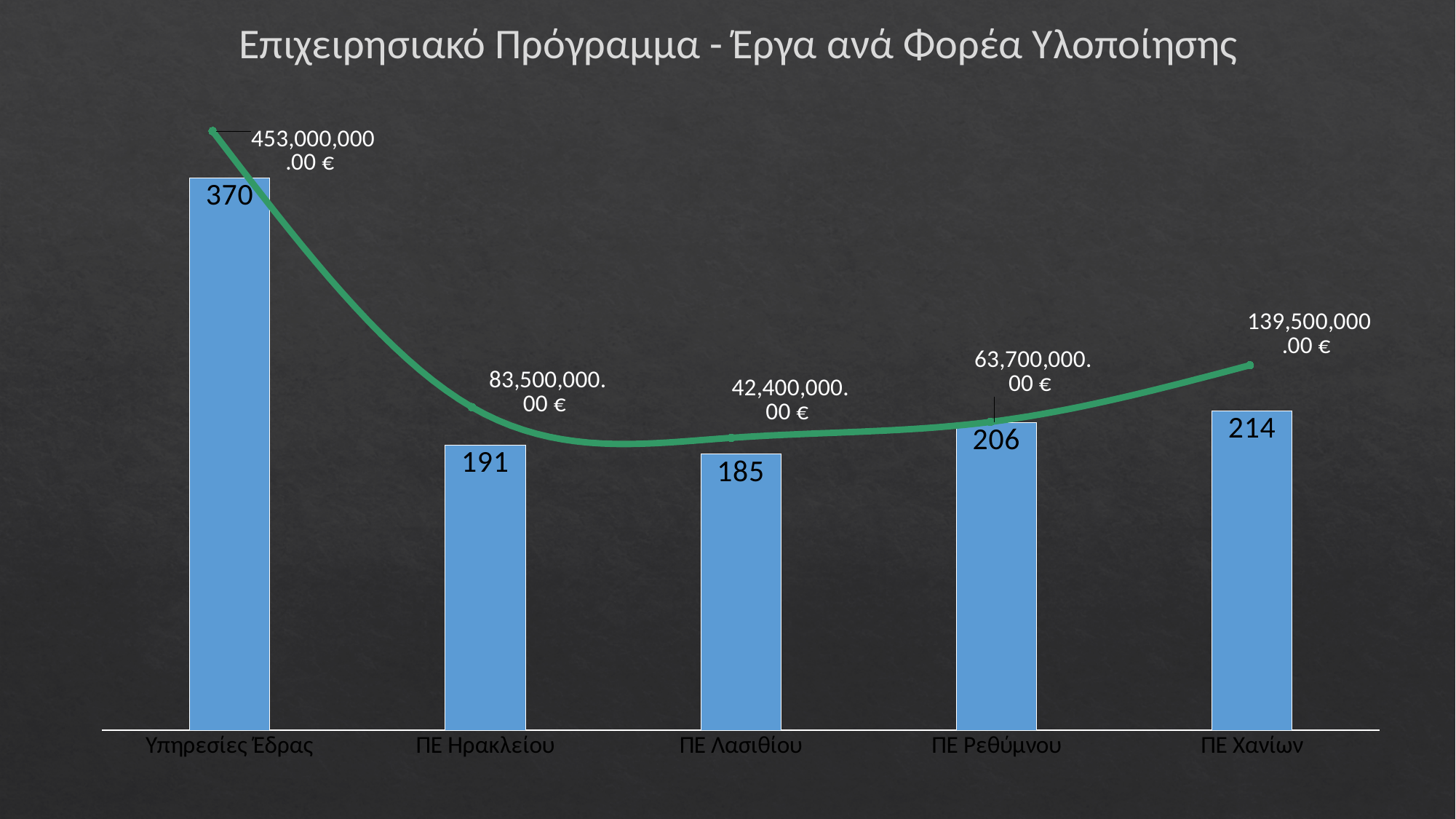
What is the euro amount shown on the line for ΠΕ Χανίων? 139,500,000.00 € How many categories are shown on the x axis? 5 What is the bar value for Υπηρεσίες Έδρας? 370 What is the euro amount shown on the line for ΠΕ Ηρακλείου? 83,500,000.00 € What is the difference between the bar values for Υπηρεσίες Έδρας and ΠΕ Ηρακλείου? 179 What is the bar value for ΠΕ Λασιθίου? 185 Which has a larger euro amount on the line, ΠΕ Ρεθύμνου or ΠΕ Λασιθίου? ΠΕ Ρεθύμνου Which category has the lowest euro amount on the line? ΠΕ Λασιθίου Which category has the highest bar value? Υπηρεσίες Έδρας What is the difference between the bar values for ΠΕ Χανίων and ΠΕ Ρεθύμνου? 8 What kind of chart is this? Bar chart with a line What is the title of the chart? Επιχειρησιακό Πρόγραμμα - Έργα ανά Φορέα Υλοποίησης